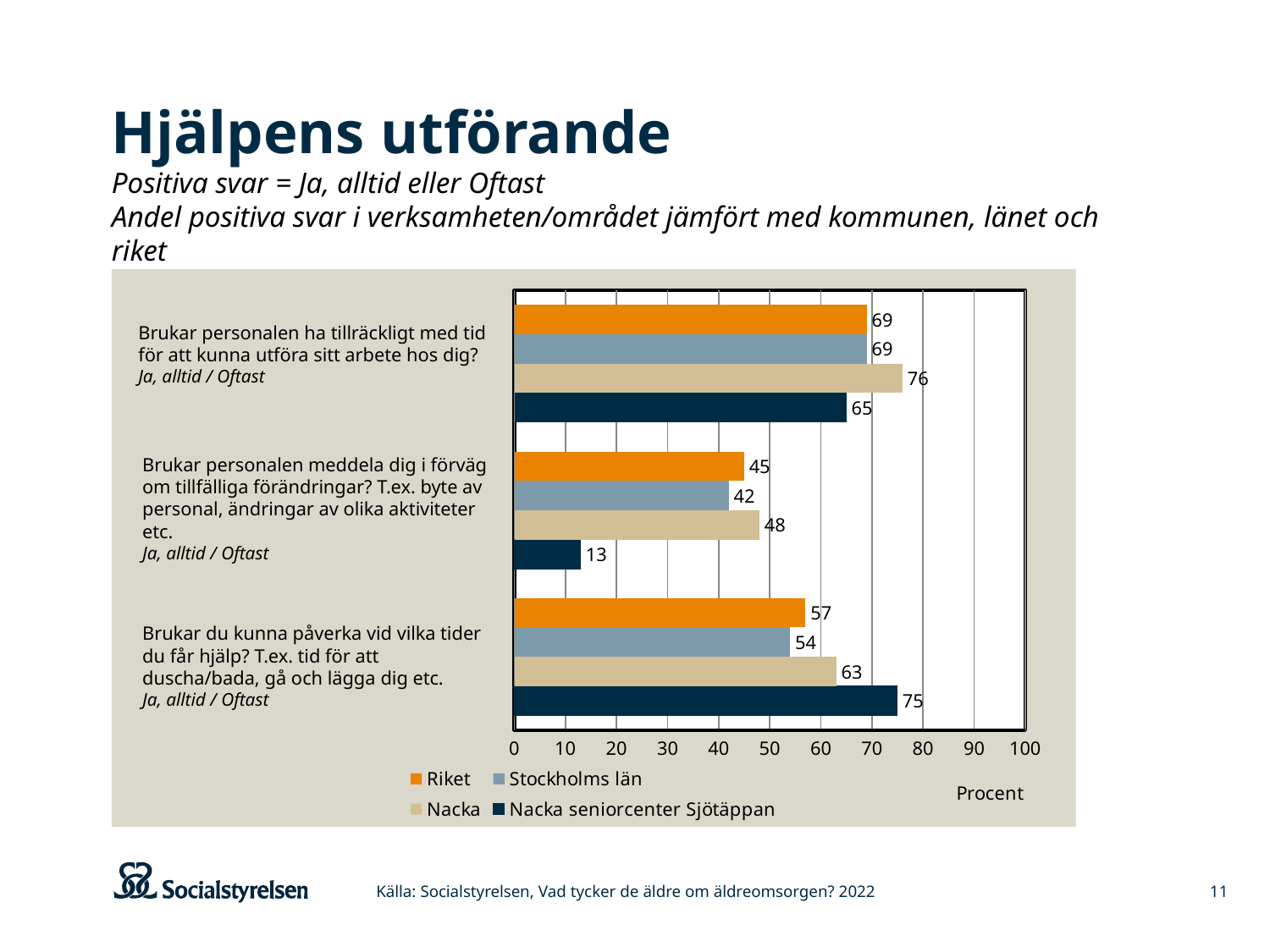
How many question categories are shown in the chart? 3 What is the value for Nacka seniorcenter Sjötäppan on the question "Brukar personalen meddela dig i förväg om tillfälliga förändringar?"? 13 What is the difference between Riket and Nacka seniorcenter Sjötäppan on the question "Brukar du kunna påverka vid vilka tider du får hjälp?"? 18 How many series does the legend list? 4 What is the value for Stockholms län on the question "Brukar du kunna påverka vid vilka tider du får hjälp?"? 54 Which series has the lowest value on the question "Brukar personalen ha tillräckligt med tid för att kunna utföra sitt arbete hos dig?"? Nacka seniorcenter Sjötäppan What kind of chart is shown on the slide? Bar chart On the question "Brukar personalen meddela dig i förväg om tillfälliga förändringar?", which is larger: Riket or Stockholms län? Riket Which series has the highest value on the question "Brukar du kunna påverka vid vilka tider du får hjälp?"? Nacka seniorcenter Sjötäppan Is the value for Nacka seniorcenter Sjötäppan on the question "Brukar du kunna påverka vid vilka tider du får hjälp?" greater or less than 70? greater What is the value for Nacka on the question "Brukar personalen ha tillräckligt med tid för att kunna utföra sitt arbete hos dig?"? 76 What is the difference between Nacka and Nacka seniorcenter Sjötäppan on the question "Brukar personalen meddela dig i förväg om tillfälliga förändringar?"? 35